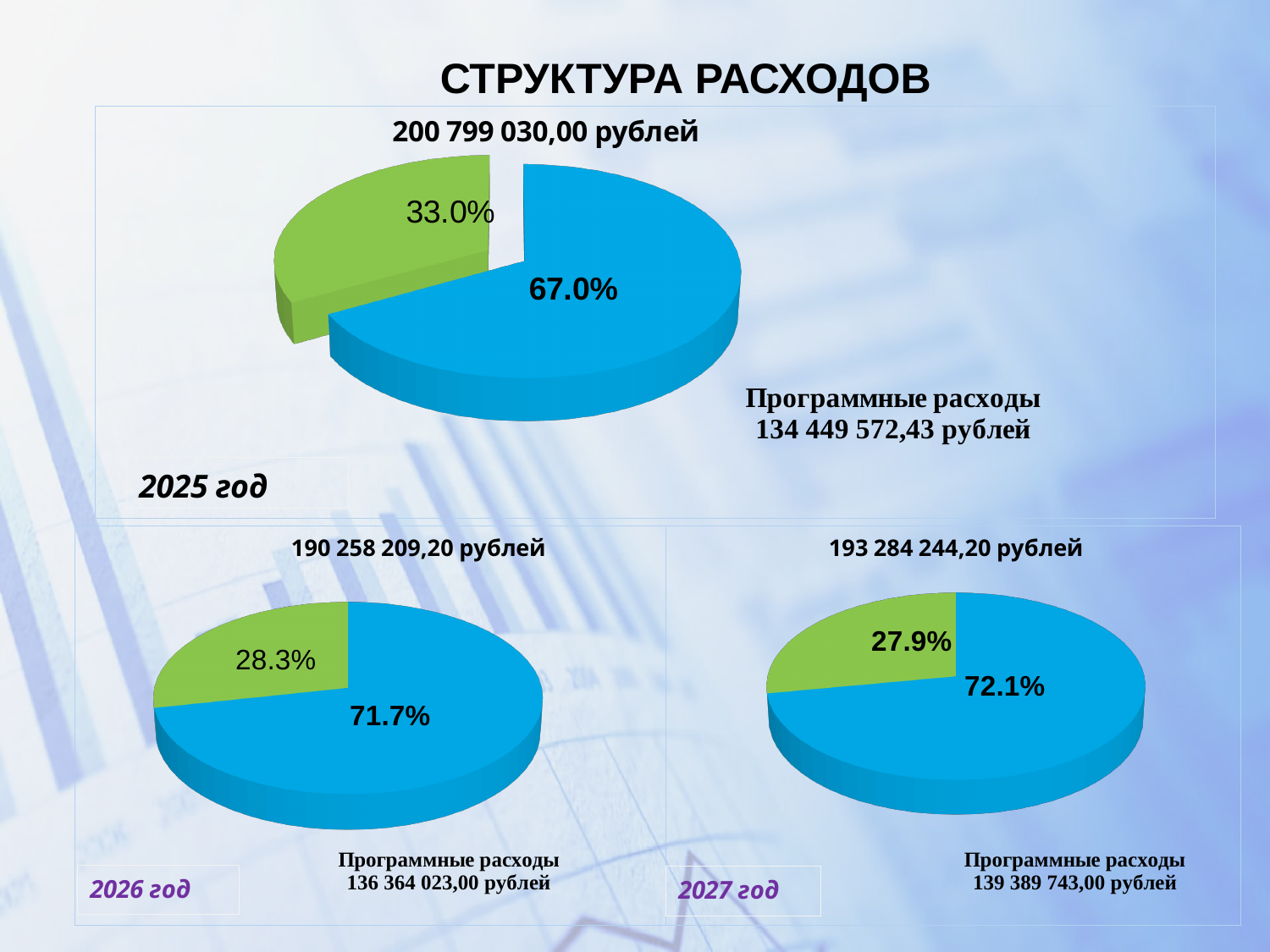
On the 2027 pie chart, which slice is larger, the blue one or the green one? The blue one How many slices does the 2026 pie chart have? 2 What total amount in rubles is shown above the 2025 pie chart? 200 799 030,00 рублей On the 2027 pie chart, what share is shown for the green slice? 27.9% Which year's pie chart shows the largest share for the green slice? 2025 What is the title of the slide containing the three pie charts? СТРУКТУРА РАСХОДОВ On the 2026 pie chart, what share is shown for the blue slice (Программные расходы)? 71.7% On the 2025 pie chart, what share is shown for the green slice? 33.0% What kind of chart is used for the 2027 data? Pie chart What is the difference between the blue and green shares on the 2026 pie chart? 43.4% What amount of Программные расходы is shown for the 2027 pie chart? 139 389 743,00 рублей